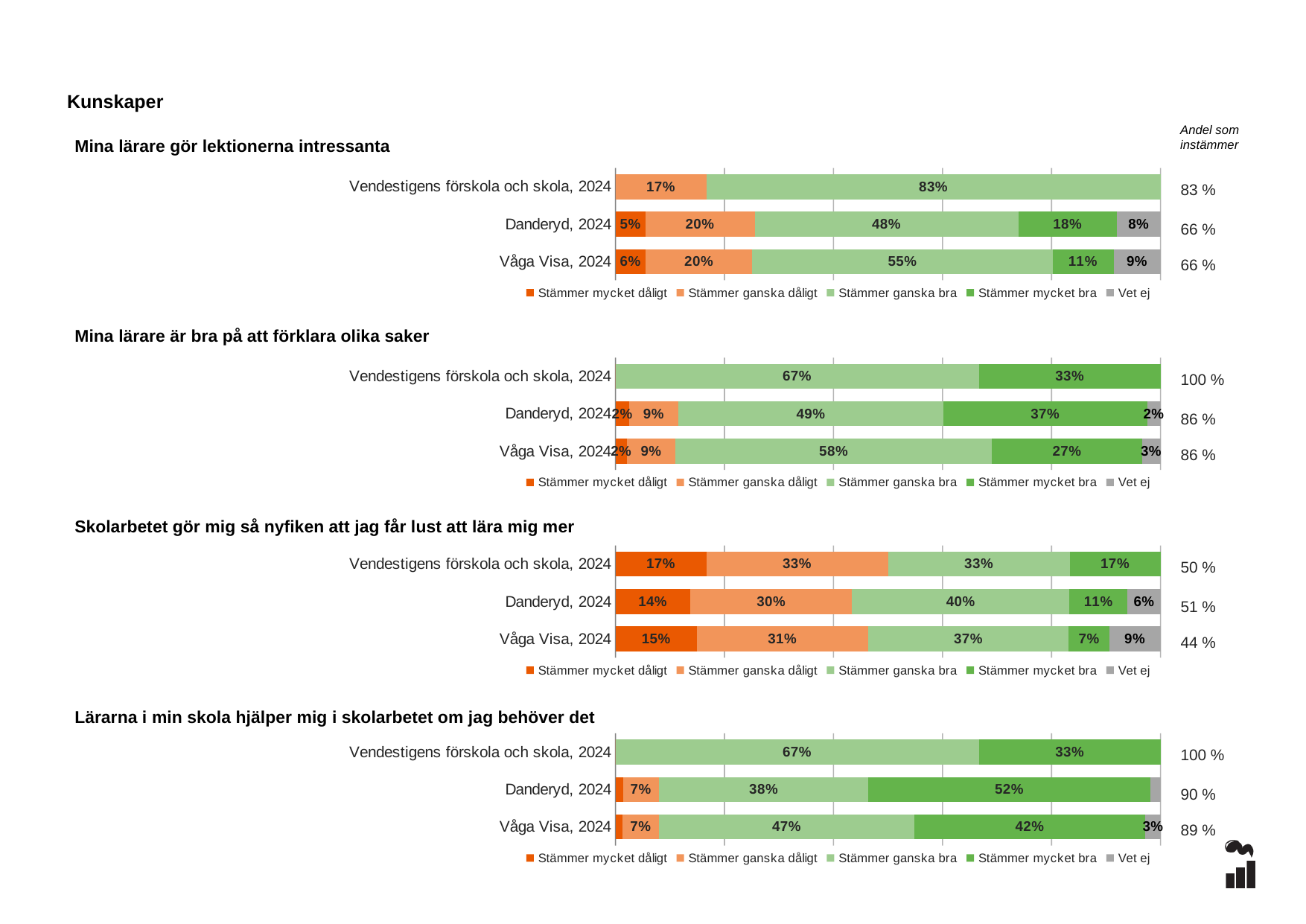
In the chart 'Skolarbetet gör mig så nyfiken att jag får lust att lära mig mer', what is the 'Andel som instämmer' for Våga Visa, 2024? 44 % In the chart 'Lärarna i min skola hjälper mig i skolarbetet om jag behöver det', what is the 'Stämmer mycket bra' value for Danderyd, 2024? 52% In the chart 'Lärarna i min skola hjälper mig i skolarbetet om jag behöver det', what is the difference between the 'Stämmer mycket bra' values for Danderyd, 2024 and Våga Visa, 2024? 10% In the chart 'Skolarbetet gör mig så nyfiken att jag får lust att lära mig mer', which row has the lowest 'Stämmer mycket bra' value? Våga Visa, 2024 In the chart 'Mina lärare gör lektionerna intressanta', which row has the highest 'Stämmer ganska bra' value? Vendestigens förskola och skola, 2024 In the chart 'Mina lärare är bra på att förklara olika saker', what is the difference between the 'Stämmer ganska bra' values for Våga Visa, 2024 and Danderyd, 2024? 9% In the chart 'Skolarbetet gör mig så nyfiken att jag får lust att lära mig mer', is the 'Stämmer ganska dåligt' value larger for Vendestigens förskola och skola, 2024 or for Danderyd, 2024? Vendestigens förskola och skola, 2024 In the chart 'Mina lärare gör lektionerna intressanta', what is the 'Vet ej' value for Våga Visa, 2024? 9% How many series does the legend list for the chart 'Mina lärare gör lektionerna intressanta'? 5 What kind of chart is used for 'Lärarna i min skola hjälper mig i skolarbetet om jag behöver det'? Stacked bar chart In the chart 'Mina lärare gör lektionerna intressanta', what is the 'Stämmer ganska bra' value for Vendestigens förskola och skola, 2024? 83% In the chart 'Mina lärare är bra på att förklara olika saker', what is the 'Stämmer mycket bra' value for Danderyd, 2024? 37%